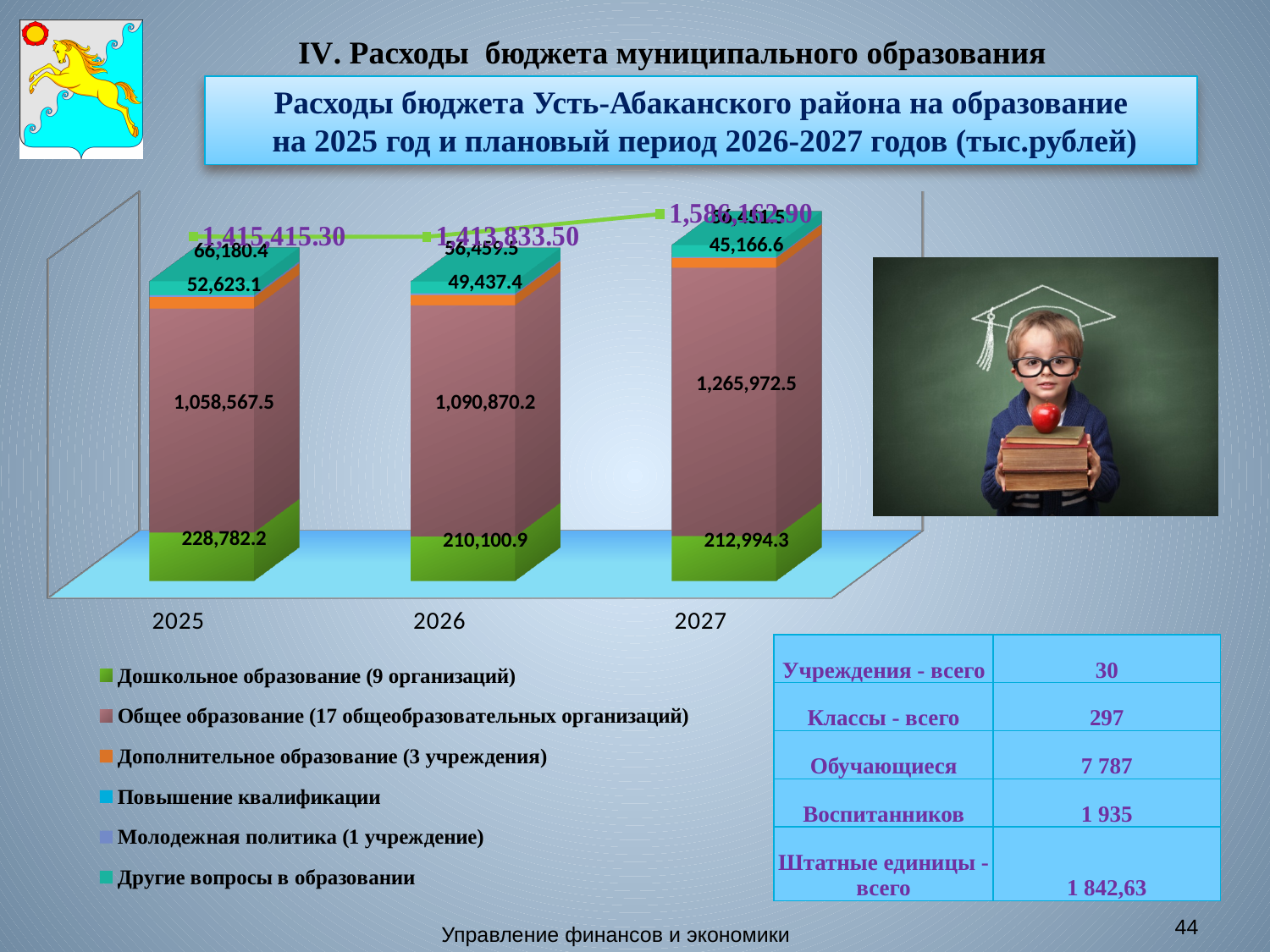
Does the value for Дополнительное образование rise or fall from 2025 to 2027? fall In which year is the value for Общее образование the highest? 2027 What is the difference between the Дополнительное образование values for 2025 and 2026? 3,185.7 What is the value for Дошкольное образование in 2026? 210,100.9 How many years are shown on the x axis of the chart? 3 What is the value for Общее образование in 2025? 1,058,567.5 How many entries does the chart legend list? 6 What is the difference between the Общее образование values for 2027 and 2026? 175,102.3 In which year is the value for Дошкольное образование the lowest? 2026 What is the value for Дополнительное образование in 2027? 45,166.6 What total is shown above the 2025 bar? 1,415,415.30 Which is larger, the Дошкольное образование value for 2025 or for 2027? 2025